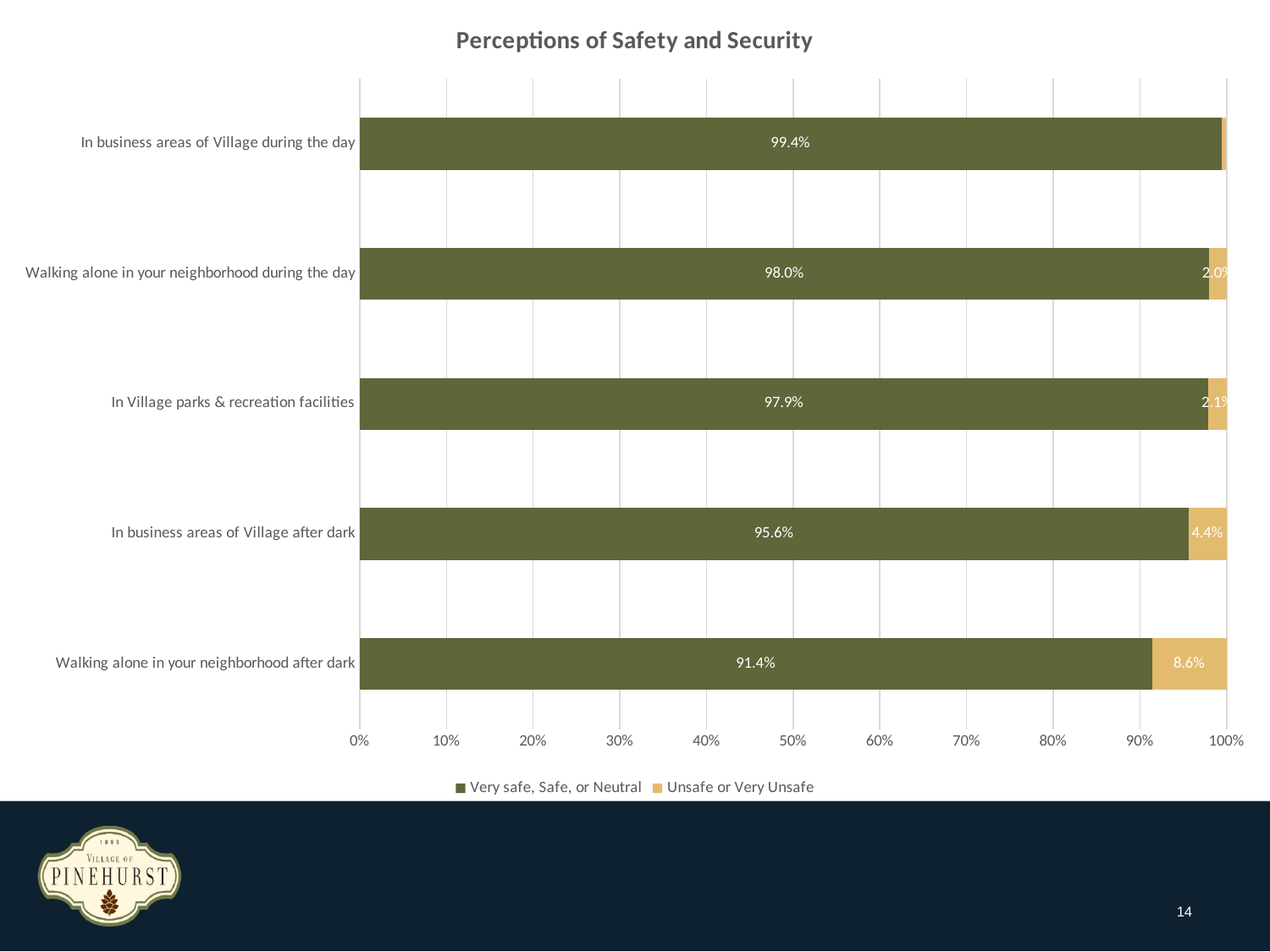
What is the 'Very safe, Safe, or Neutral' value for 'Walking alone in your neighborhood after dark'? 91.4% What is the title of the chart? Perceptions of Safety and Security What kind of chart is shown on the slide? Bar chart How many series does the legend list? 2 What is the 'Unsafe or Very Unsafe' value for 'Walking alone in your neighborhood after dark'? 8.6% What is the 'Very safe, Safe, or Neutral' value for 'In business areas of Village during the day'? 99.4% Which is larger: the 'Unsafe or Very Unsafe' value for 'Walking alone in your neighborhood after dark' or for 'In business areas of Village after dark'? Walking alone in your neighborhood after dark What is the difference between the 'Very safe, Safe, or Neutral' values for 'In business areas of Village during the day' and 'Walking alone in your neighborhood after dark'? 8.0% Which category has the highest 'Very safe, Safe, or Neutral' value? In business areas of Village during the day What is the 'Unsafe or Very Unsafe' value for 'In business areas of Village after dark'? 4.4% Which category has the lowest 'Very safe, Safe, or Neutral' value? Walking alone in your neighborhood after dark How many categories are shown on the chart? 5